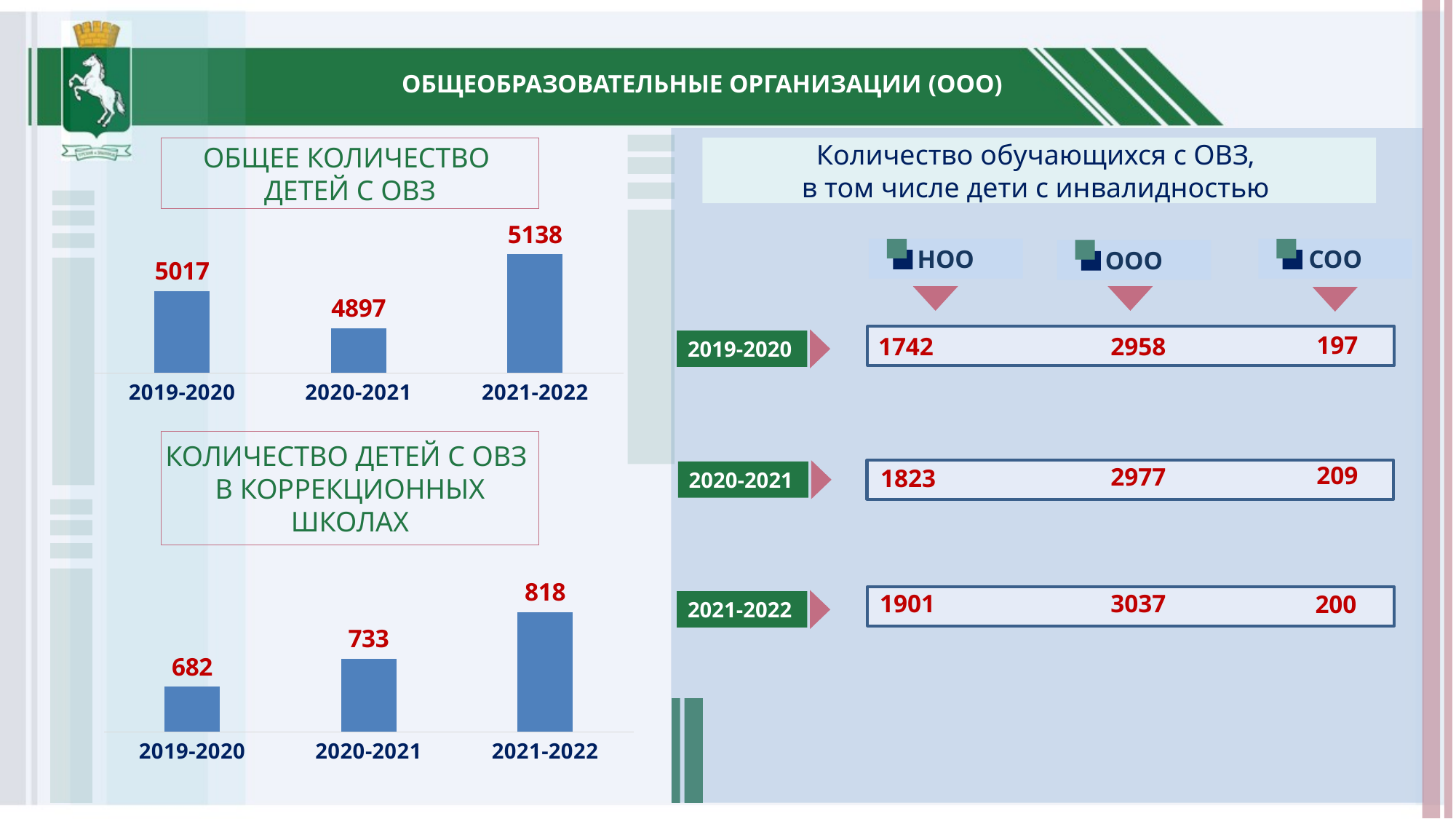
In the chart 'ОБЩЕЕ КОЛИЧЕСТВО ДЕТЕЙ С ОВЗ', what is the difference between the values for 2021-2022 and 2019-2020? 121 In the chart 'ОБЩЕЕ КОЛИЧЕСТВО ДЕТЕЙ С ОВЗ', what is the value for 2019-2020? 5017 In the chart 'КОЛИЧЕСТВО ДЕТЕЙ С ОВЗ В КОРРЕКЦИОННЫХ ШКОЛАХ', do the values rise or fall from 2019-2020 to 2021-2022? rise In the chart 'КОЛИЧЕСТВО ДЕТЕЙ С ОВЗ В КОРРЕКЦИОННЫХ ШКОЛАХ', what is the value for 2019-2020? 682 In the chart 'КОЛИЧЕСТВО ДЕТЕЙ С ОВЗ В КОРРЕКЦИОННЫХ ШКОЛАХ', which is larger, the value for 2020-2021 or 2021-2022? 2021-2022 What type of chart is 'КОЛИЧЕСТВО ДЕТЕЙ С ОВЗ В КОРРЕКЦИОННЫХ ШКОЛАХ'? bar chart How many bars are in the chart 'ОБЩЕЕ КОЛИЧЕСТВО ДЕТЕЙ С ОВЗ'? 3 In the chart 'ОБЩЕЕ КОЛИЧЕСТВО ДЕТЕЙ С ОВЗ', which year has the lowest value? 2020-2021 In the chart 'КОЛИЧЕСТВО ДЕТЕЙ С ОВЗ В КОРРЕКЦИОННЫХ ШКОЛАХ', what is the difference between the values for 2020-2021 and 2019-2020? 51 In the chart 'КОЛИЧЕСТВО ДЕТЕЙ С ОВЗ В КОРРЕКЦИОННЫХ ШКОЛАХ', what is the value for 2021-2022? 818 In the chart 'ОБЩЕЕ КОЛИЧЕСТВО ДЕТЕЙ С ОВЗ', which year has the highest value? 2021-2022 In the chart 'ОБЩЕЕ КОЛИЧЕСТВО ДЕТЕЙ С ОВЗ', what is the value for 2020-2021? 4897